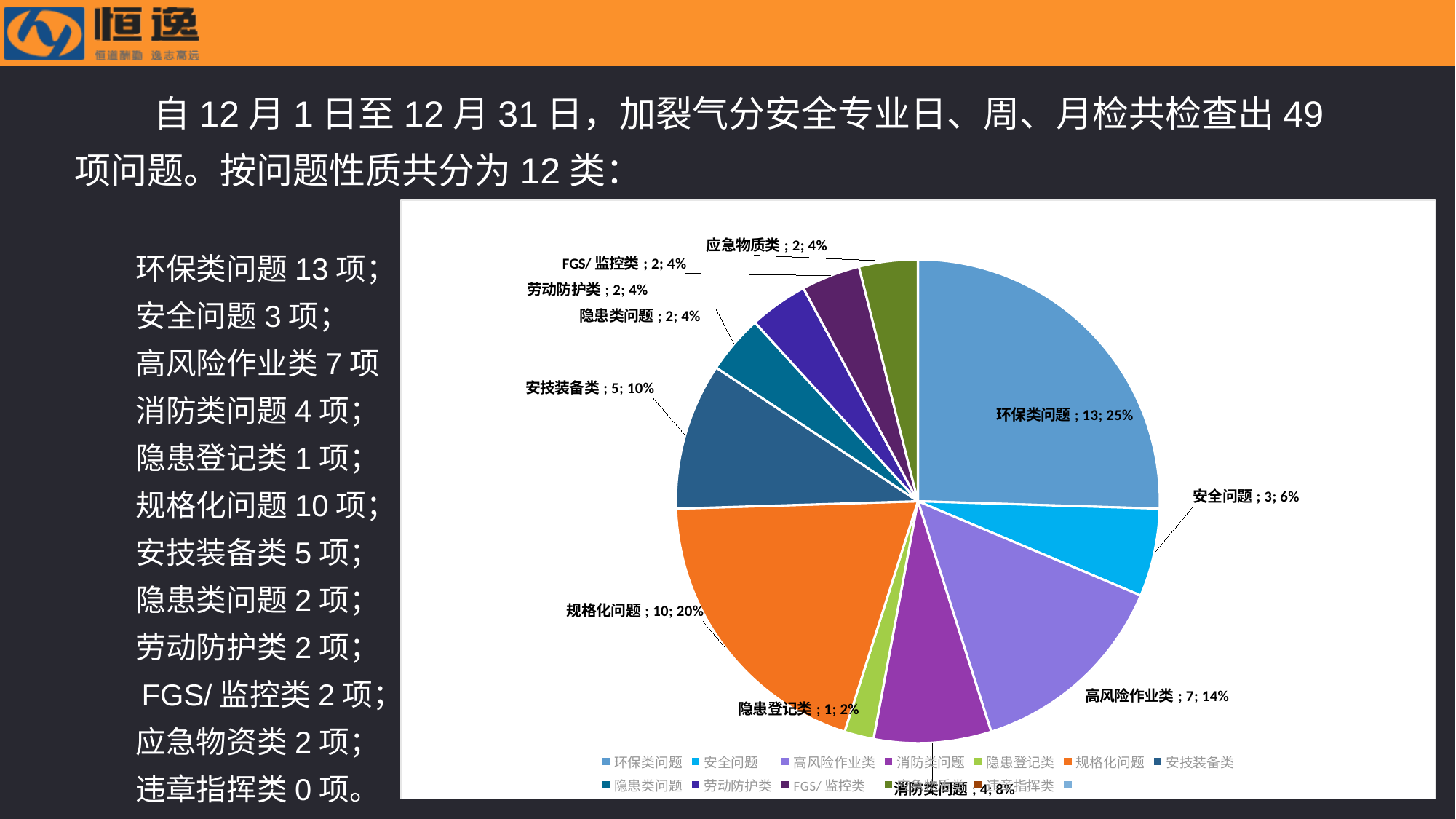
What is the difference between the values for 环保类问题 and 规格化问题? 3 What percentage share does 安技装备类 have in the pie chart? 10% Which labelled category has the smallest slice in the pie chart? 隐患登记类 What is the value shown for 劳动防护类 in the pie chart? 2 Which is larger, the value for 消防类问题 or the value for 安全问题? 消防类问题 What percentage share does 安全问题 have in the pie chart? 6% What is the value shown for 环保类问题 in the pie chart? 13 What percentage share does 规格化问题 have in the pie chart? 20% What is the value shown for 高风险作业类 in the pie chart? 7 What is the difference between the values for 高风险作业类 and 安技装备类? 2 What type of chart is shown on the slide? pie chart Which category has the largest slice in the pie chart? 环保类问题